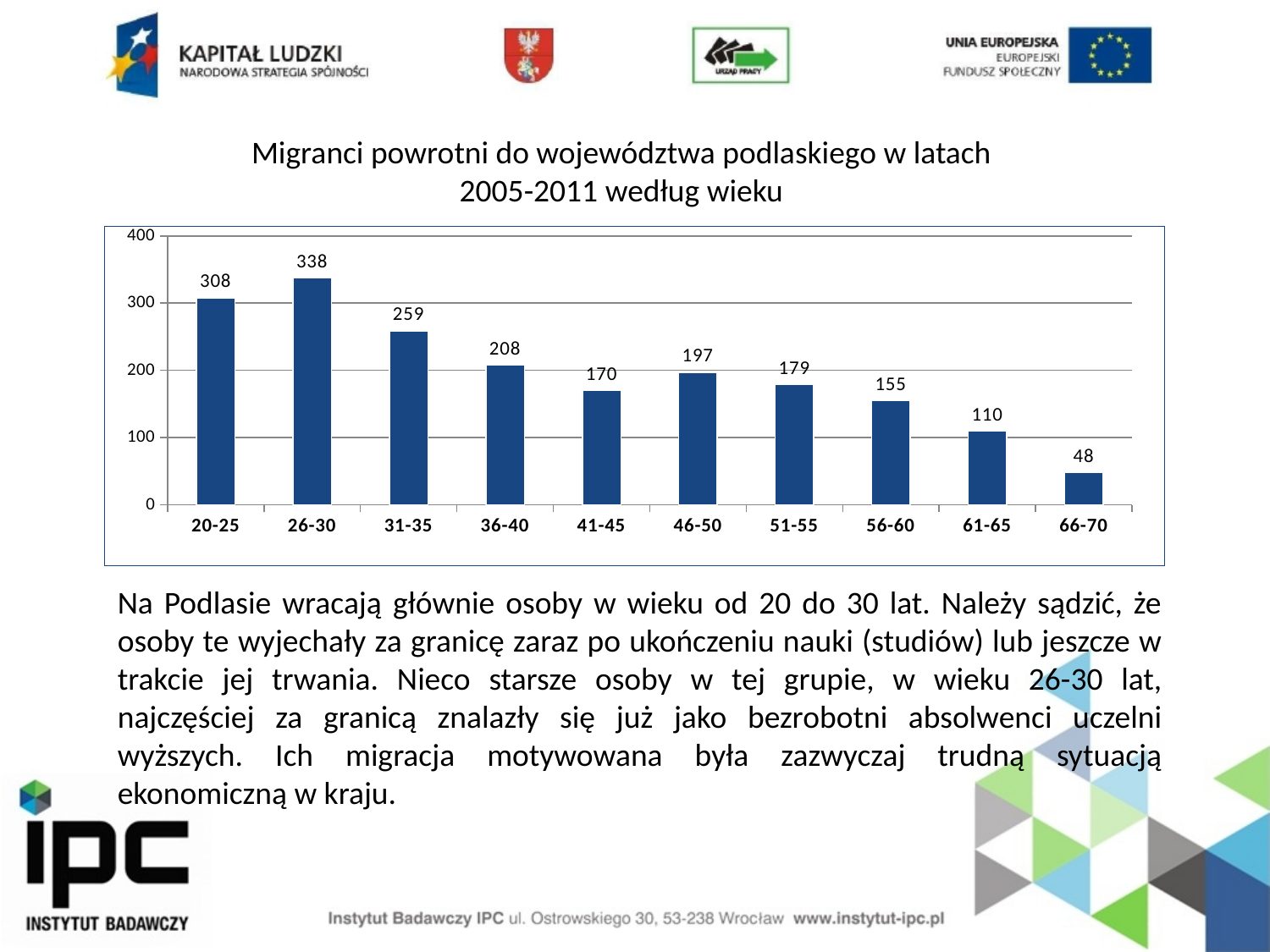
What is the difference between the values for 31-35 and 36-40? 51 Is the value for 56-60 greater or less than 200? less What is the value for the 46-50 age group? 197 How many age groups are shown on the chart? 10 What is the difference between the values for 20-25 and 26-30? 30 Which age group has the highest value? 26-30 Which is larger, the value for 41-45 or the value for 46-50? 46-50 Which age group has the lowest value? 66-70 What is the value for the 26-30 age group? 338 What is the value for the 66-70 age group? 48 What kind of chart is shown on the slide? bar chart What is the title of the chart? Migranci powrotni do województwa podlaskiego w latach 2005-2011 według wieku